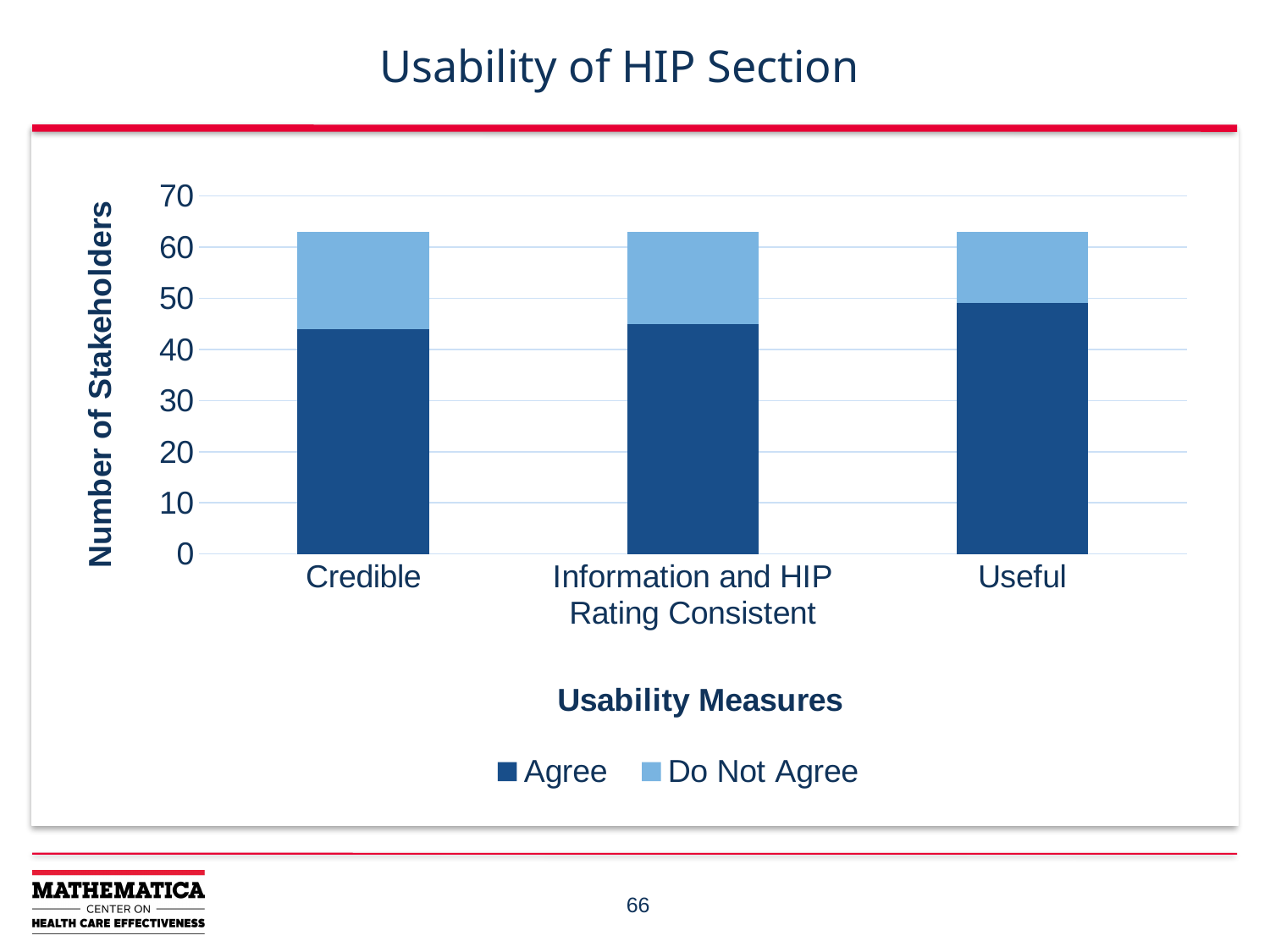
Is the Agree value for Useful greater or less than 40? greater Is the total height of the Useful bar greater or less than 70? less Is the total height of the Credible bar greater or less than 60? greater What kind of chart is shown on the slide? stacked bar chart What is the title of the chart? Usability of HIP Section Which usability measure has the lowest Do Not Agree value? Useful How many categories are shown on the x axis? 3 Which usability measure has the highest Agree value? Useful How many series does the legend list? 2 What are the two series listed in the legend? Agree and Do Not Agree